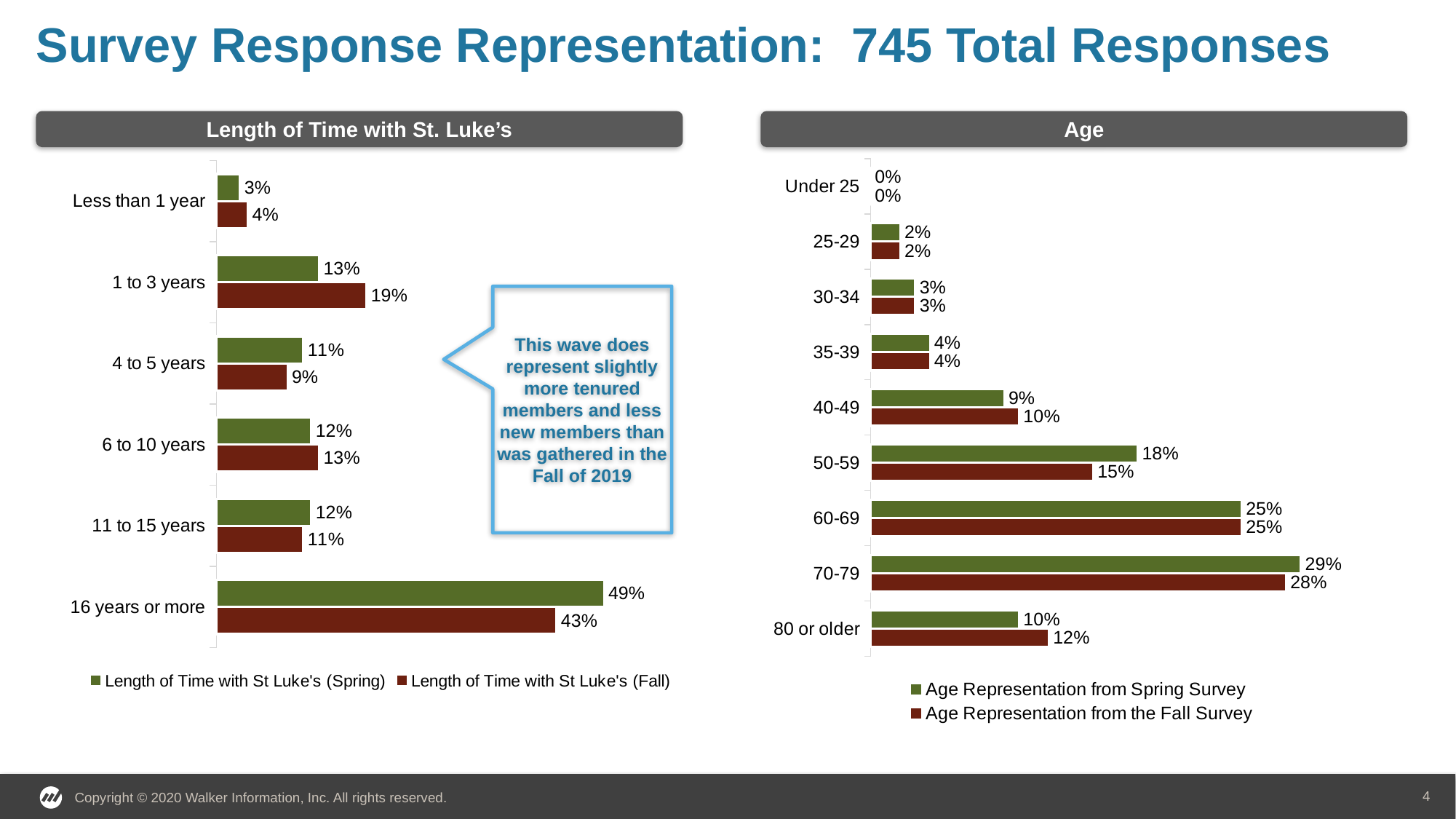
In the 'Age' chart, how many series does the legend list? 2 In the 'Length of Time with St. Luke's' chart, what is the difference between the Spring and Fall values for '16 years or more'? 6% What type of chart is the 'Age' chart? Bar chart In the 'Length of Time with St. Luke's' chart, how many categories are shown? 6 In the 'Age' chart, what is the Fall value for '50-59'? 15% In the 'Length of Time with St. Luke's' chart, which category has the highest Spring value? 16 years or more In the 'Length of Time with St. Luke's' chart, what is the Fall value for '1 to 3 years'? 19% In the 'Age' chart, is the Spring value for '50-59' larger or smaller than the Fall value for '50-59'? larger In the 'Length of Time with St. Luke's' chart, which category has the lowest Fall value? Less than 1 year In the 'Length of Time with St. Luke's' chart, what is the Spring value for '16 years or more'? 49% In the 'Age' chart, what is the Spring value for '70-79'? 29% In the 'Age' chart, which age group has the highest Fall value? 70-79